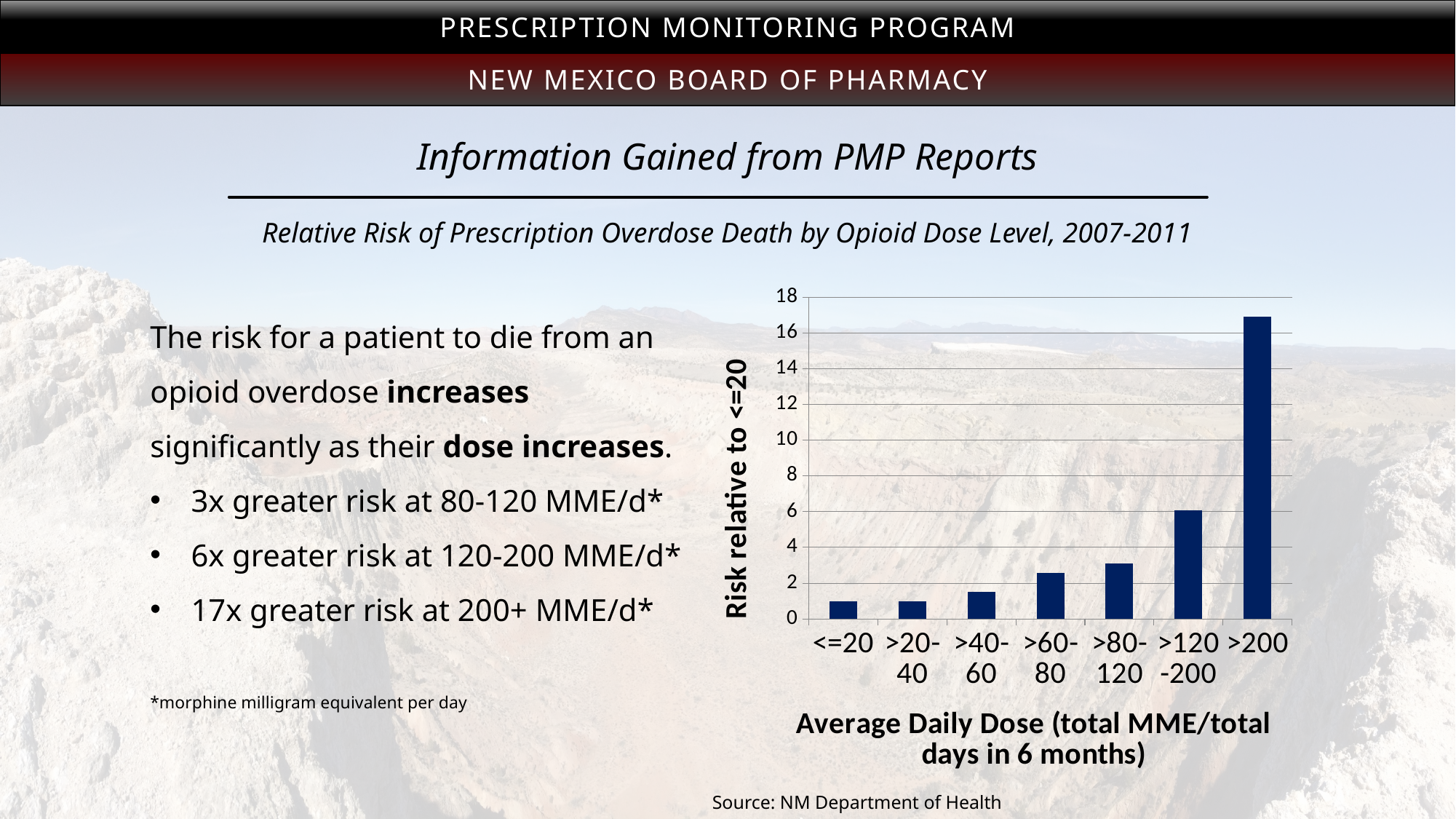
How many dose-level categories are shown on the x axis of the chart? 7 Is the value for >60-80 greater or less than 2? greater Is the value for >80-120 greater or less than 4? less Is the value for >200 greater or less than 16? greater Which dose level has the highest relative risk in the chart? >200 What is the title of the chart? Relative Risk of Prescription Overdose Death by Opioid Dose Level, 2007-2011 What is the label of the chart's y axis? Risk relative to <=20 Which has a larger relative risk, >120-200 or >80-120? >120-200 Do the relative risk values rise or fall as the dose level increases along the x axis? rise What kind of chart is shown on the slide? bar chart